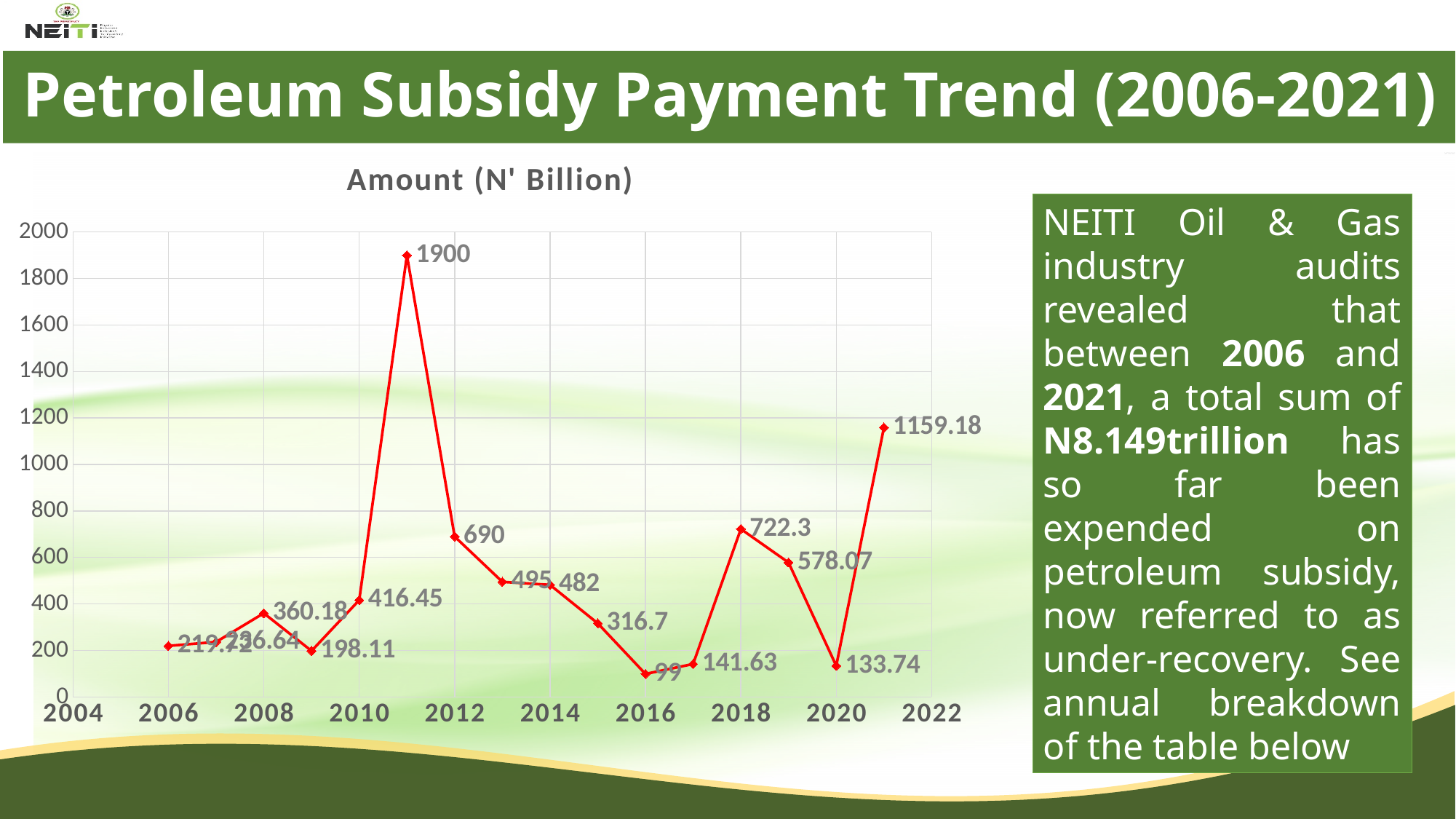
What is the difference between the 2021 value and the 2020 value? 1025.44 Which year has the highest subsidy payment amount? 2011 Do the values rise or fall from 2012 to 2016? fall Which year has the lowest subsidy payment amount? 2016 What is the subsidy payment amount for 2021? 1159.18 What is the difference between the 2011 value and the 2012 value? 1210 What is the subsidy payment amount for 2018? 722.3 Which year has the larger value, 2018 or 2019? 2018 How many data points are plotted on the line? 16 What is the subsidy payment amount for 2020? 133.74 What kind of chart is shown on the slide? line chart What is the subsidy payment amount for 2012? 690